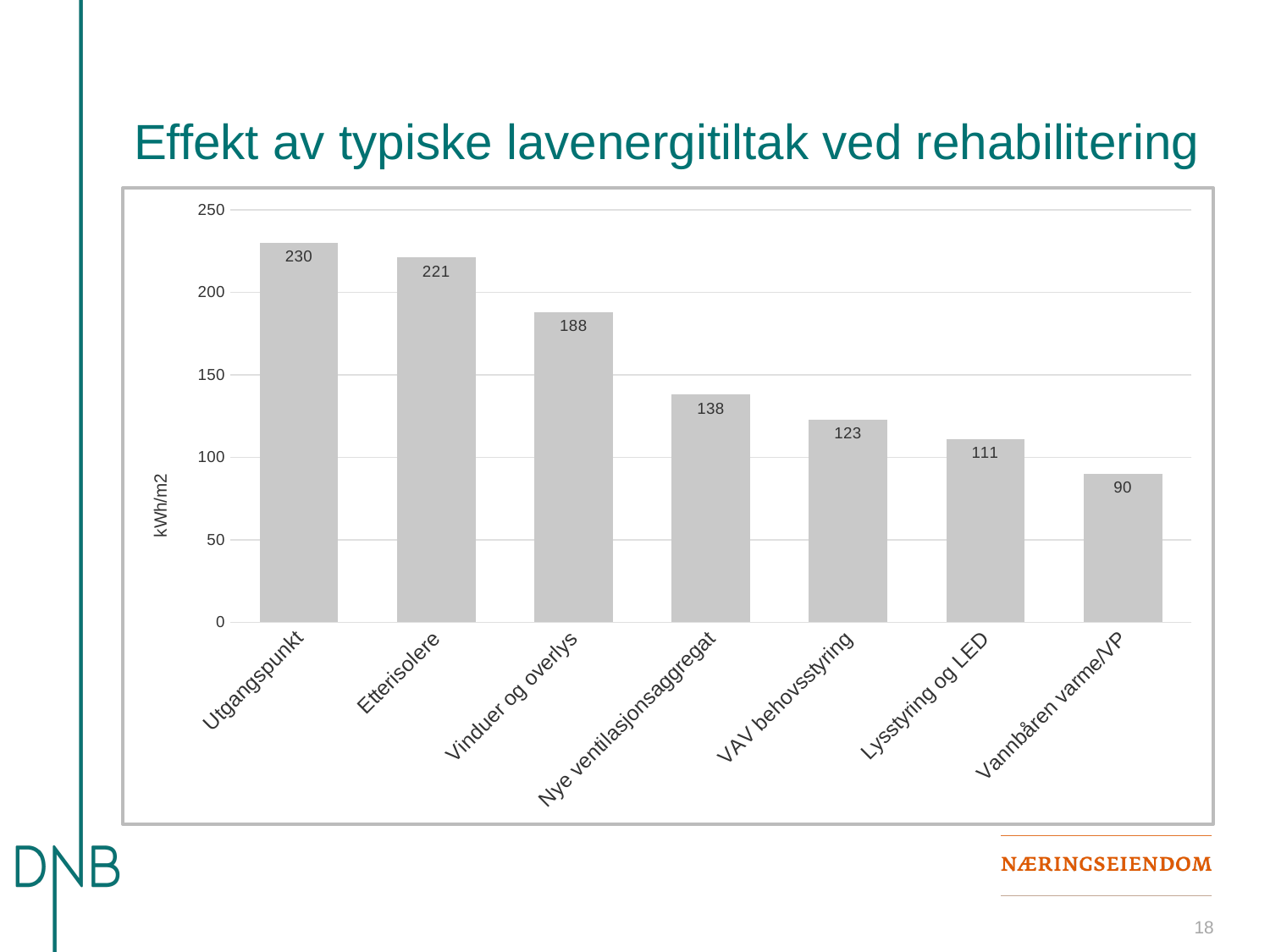
Which category has the highest value? Utgangspunkt What kind of chart is shown on the slide? bar chart What is the label on the vertical axis? kWh/m2 Which category has the lowest value? Vannbåren varme/VP What is the value for Utgangspunkt? 230 What is the value for Vannbåren varme/VP? 90 What is the value for Nye ventilasjonsaggregat? 138 Is the value for Vinduer og overlys greater or less than 150? greater Which is larger, the value for VAV behovsstyring or the value for Lysstyring og LED? VAV behovsstyring What is the difference between the values for Utgangspunkt and Etterisolere? 9 What is the difference between the values for Vinduer og overlys and Lysstyring og LED? 77 How many categories are shown on the x axis? 7